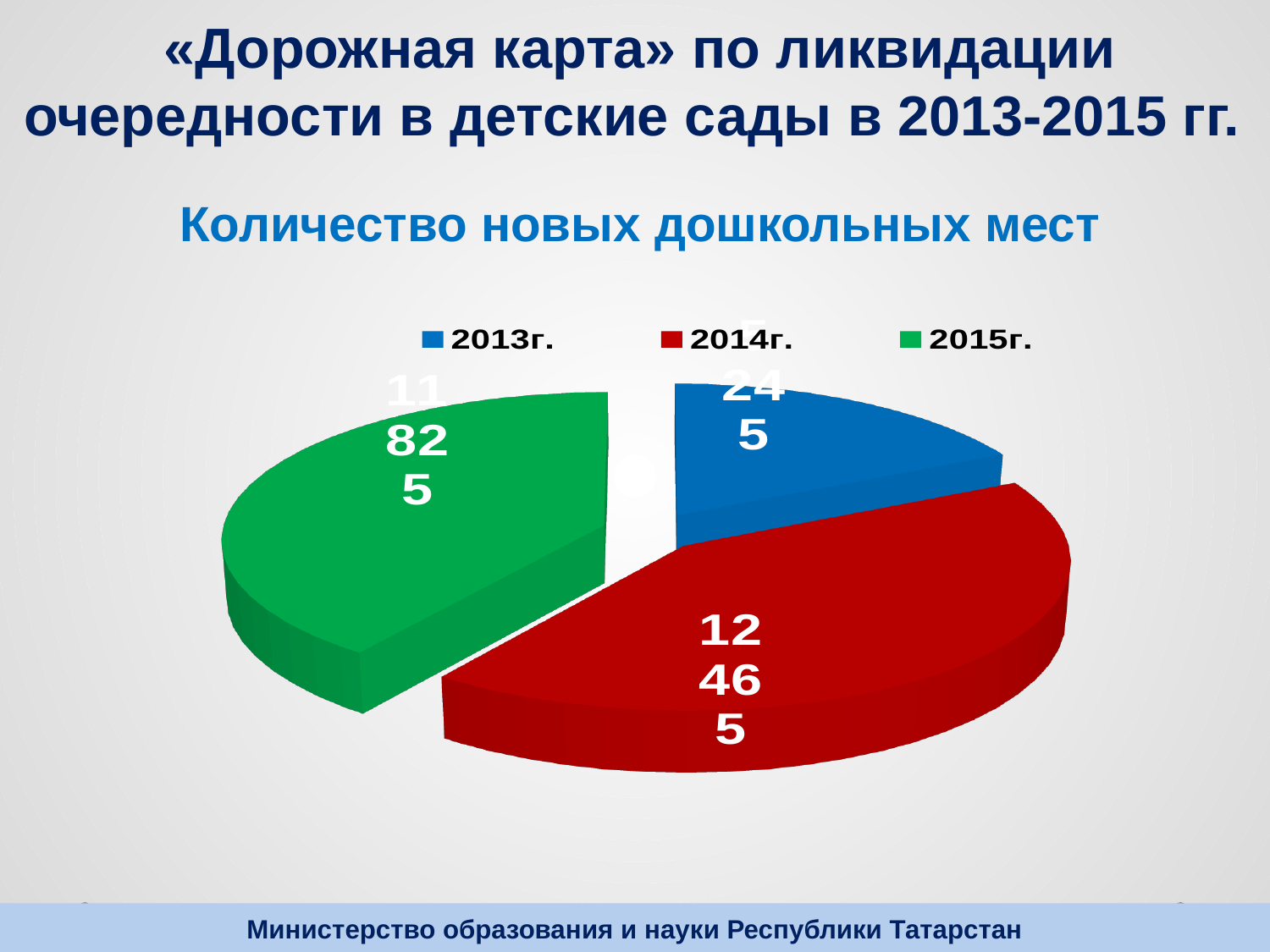
Which year has the largest slice in the pie chart? 2014г. What is the value shown for 2014г. in the pie chart? 12465 How many entries does the legend list? 3 What is the title of the chart? Количество новых дошкольных мест Which is larger, the value for 2014г. or the value for 2015г.? 2014г. What colour is the slice for 2014г.? Red What is the value shown for 2015г. in the pie chart? 11825 Which slice is larger, 2013г. or 2015г.? 2015г. Which year has the smallest slice in the pie chart? 2013г. What type of chart is shown on the slide? Pie chart How many slices does the pie chart have? 3 What is the difference between the values for 2014г. and 2015г.? 640